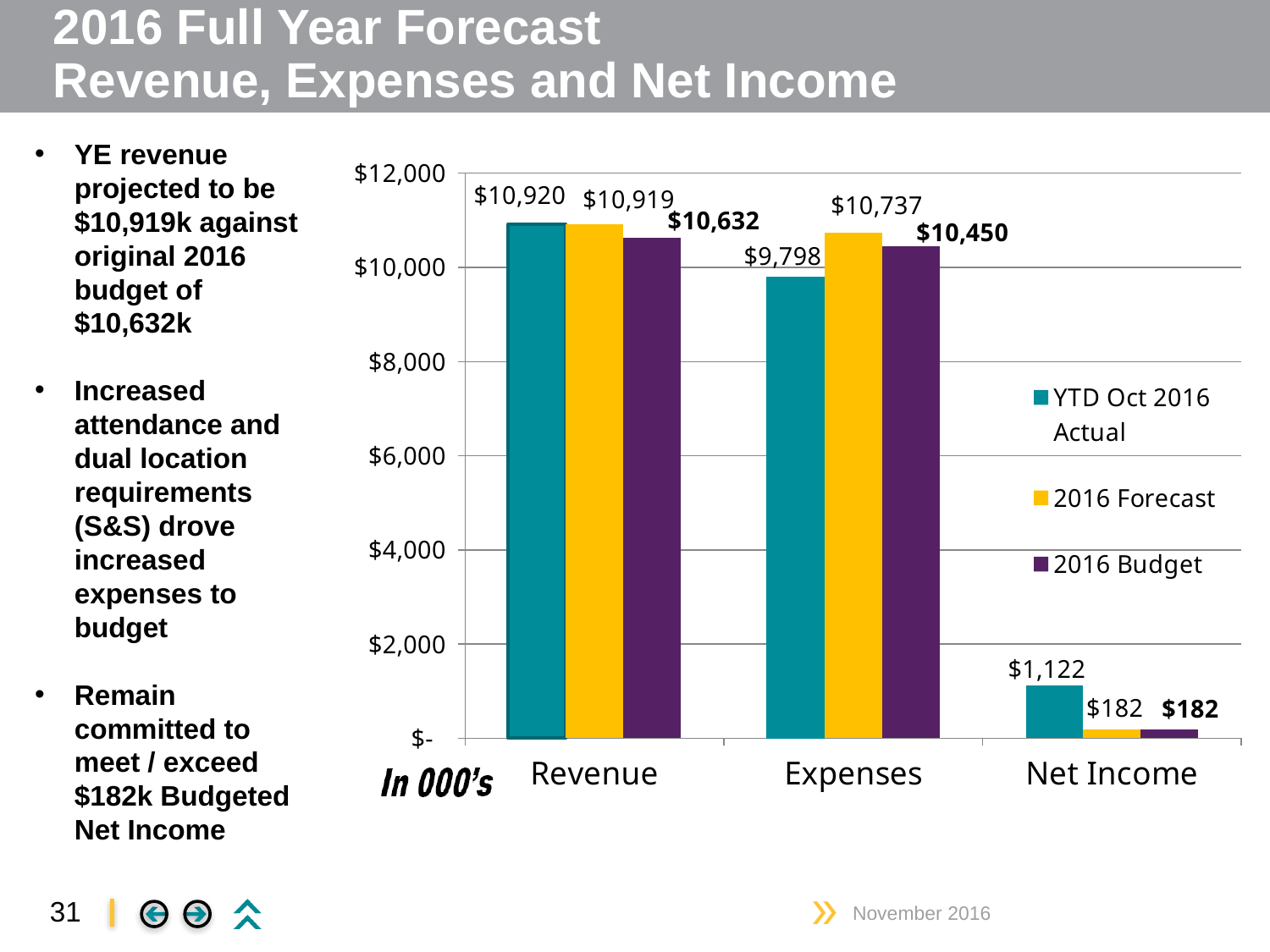
Is the YTD Oct 2016 Actual value for Net Income greater or less than $2,000? less Is the YTD Oct 2016 Actual value for Expenses larger or smaller than the 2016 Budget value for Expenses? smaller Which category has the lowest 2016 Forecast value? Net Income What is the YTD Oct 2016 Actual value for Net Income? $1,122 What kind of chart is shown on the slide? bar chart What is the 2016 Budget value for Net Income? $182 What is the difference between the 2016 Forecast and 2016 Budget values for Revenue? $287 How many categories are shown on the x axis? 3 Which series has the highest value for Expenses? 2016 Forecast What is the YTD Oct 2016 Actual value for Revenue? $10,920 What is the 2016 Forecast value for Expenses? $10,737 How many series does the legend list? 3